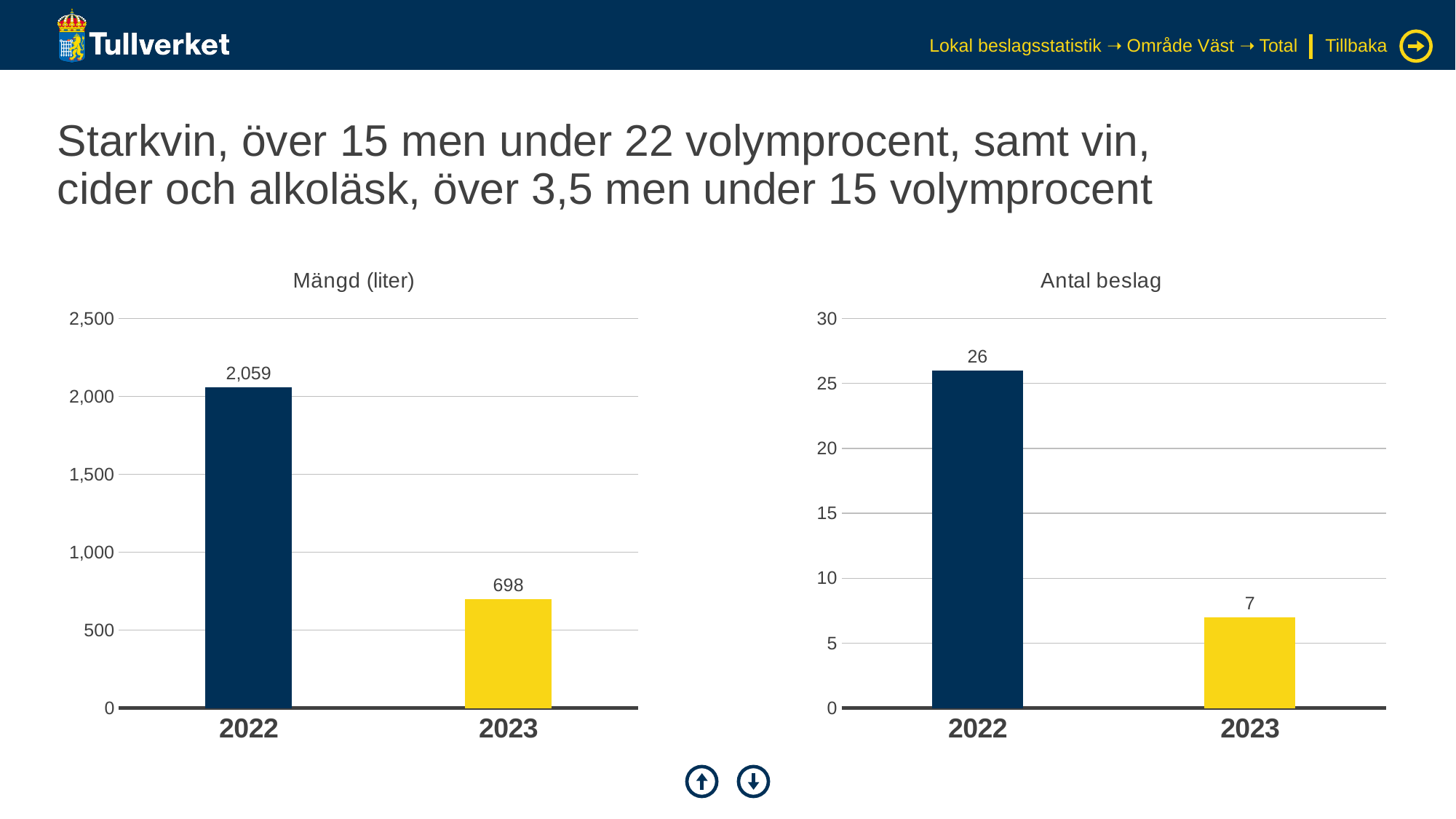
In the 'Antal beslag' chart, what is the value for 2023? 7 In the 'Mängd (liter)' chart, what is the value for 2022? 2,059 In the 'Antal beslag' chart, is the value for 2022 greater or less than 20? greater In the 'Mängd (liter)' chart, do the values rise or fall from 2022 to 2023? fall In the 'Mängd (liter)' chart, what is the value for 2023? 698 In the 'Antal beslag' chart, what is the value for 2022? 26 In the 'Antal beslag' chart, what is the difference between the 2022 and 2023 values? 19 In the 'Mängd (liter)' chart, what is the difference between the 2022 and 2023 values? 1,361 In the 'Mängd (liter)' chart, how many years are shown on the x axis? 2 In the 'Antal beslag' chart, which year has the lowest value? 2023 In the 'Mängd (liter)' chart, which year has the highest value? 2022 What kind of chart is the 'Antal beslag' chart? bar chart